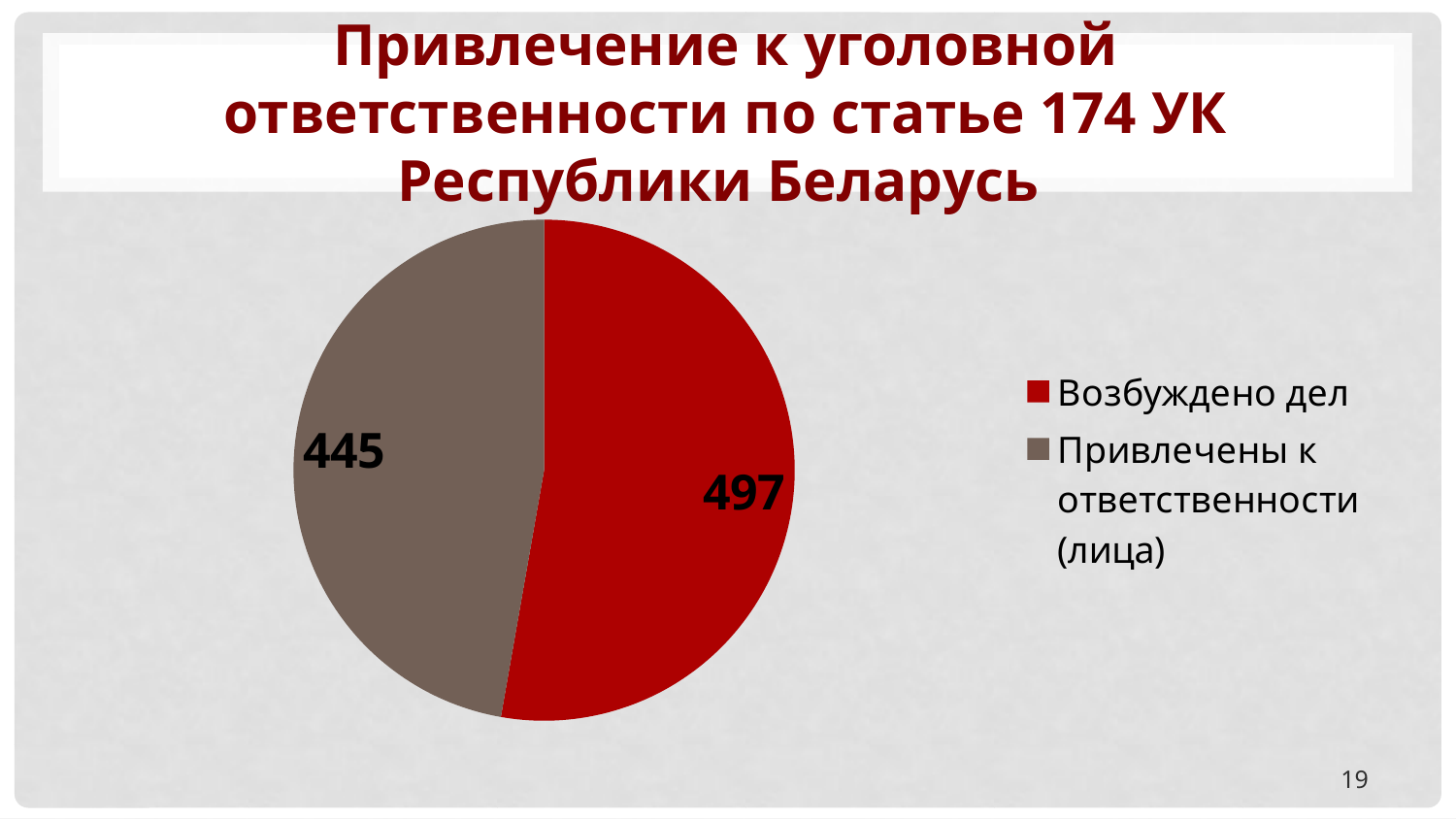
What is the value for "Привлечены к ответственности (лица)"? 445 What is the total of the two values shown in the pie chart? 942 What type of chart is shown on the slide? Pie chart Which category has the larger value? Возбуждено дел What is the title of the slide containing the chart? Привлечение к уголовной ответственности по статье 174 УК Республики Беларусь Is the value for "Возбуждено дел" larger or smaller than the value for "Привлечены к ответственности (лица)"? Larger What is the value for "Возбуждено дел"? 497 Which category has the smaller value? Привлечены к ответственности (лица) How many slices does the pie chart have? 2 How many entries does the legend list? 2 What is the difference between the values for "Возбуждено дел" and "Привлечены к ответственности (лица)"? 52 What colour is the slice for "Возбуждено дел"? Red